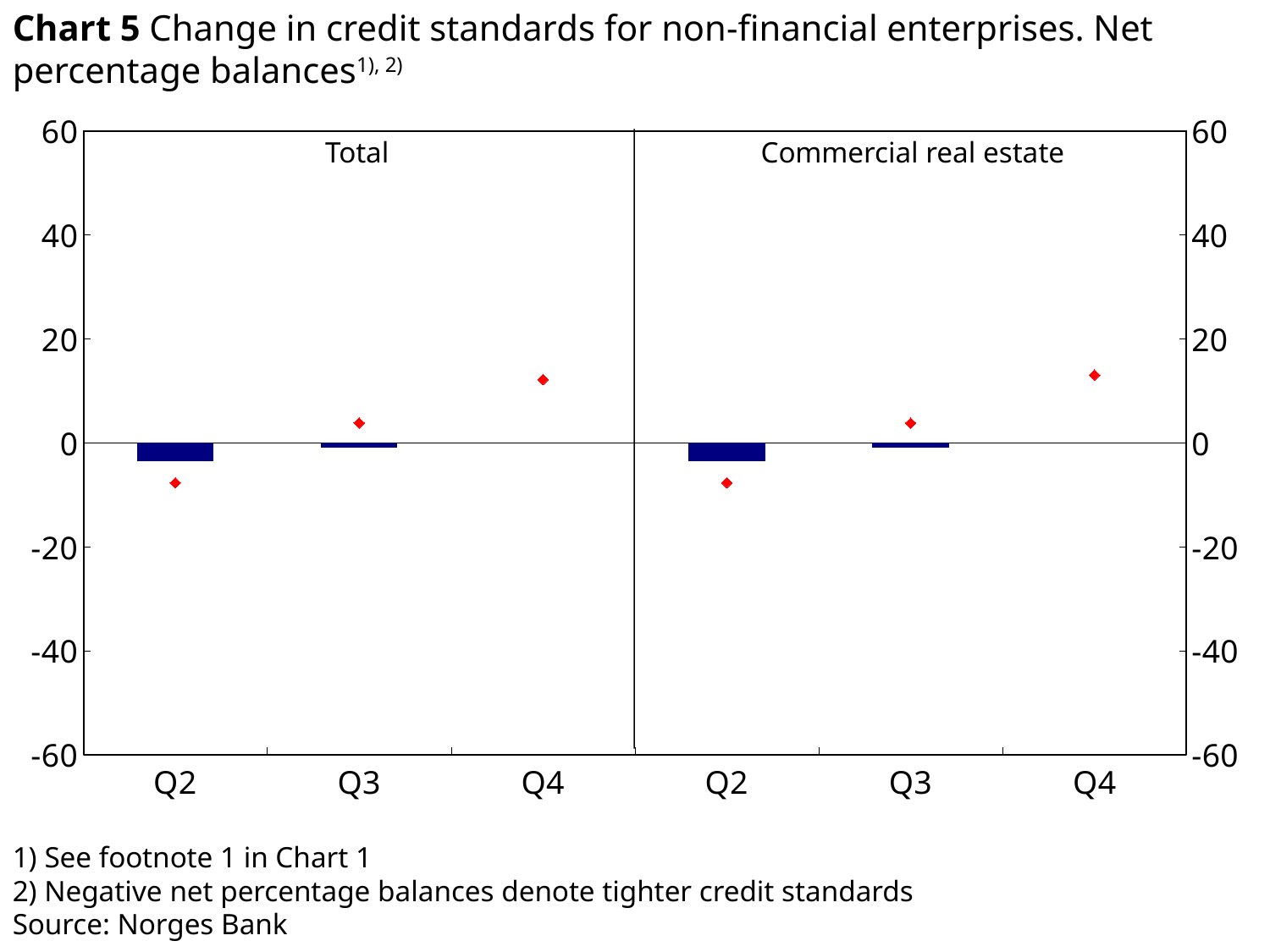
What is the source given for the chart? Norges Bank In the Commercial real estate panel, is the red diamond for Q2 greater or less than -20? greater What are the names of the two panels in the chart? Total and Commercial real estate In the Total panel, is the red diamond for Q4 greater or less than 20? less In the Commercial real estate panel, is the red diamond for Q4 greater or less than 20? less In the Total panel, do the red diamonds rise or fall from Q2 to Q4? rise In the Total panel, which quarter has the lowest red diamond? Q2 What kind of chart is Chart 5? combination bar and line chart (bars with diamond markers) In the Commercial real estate panel, which quarter has the highest red diamond? Q4 How many quarters are shown on the x axis of the Total panel? 3